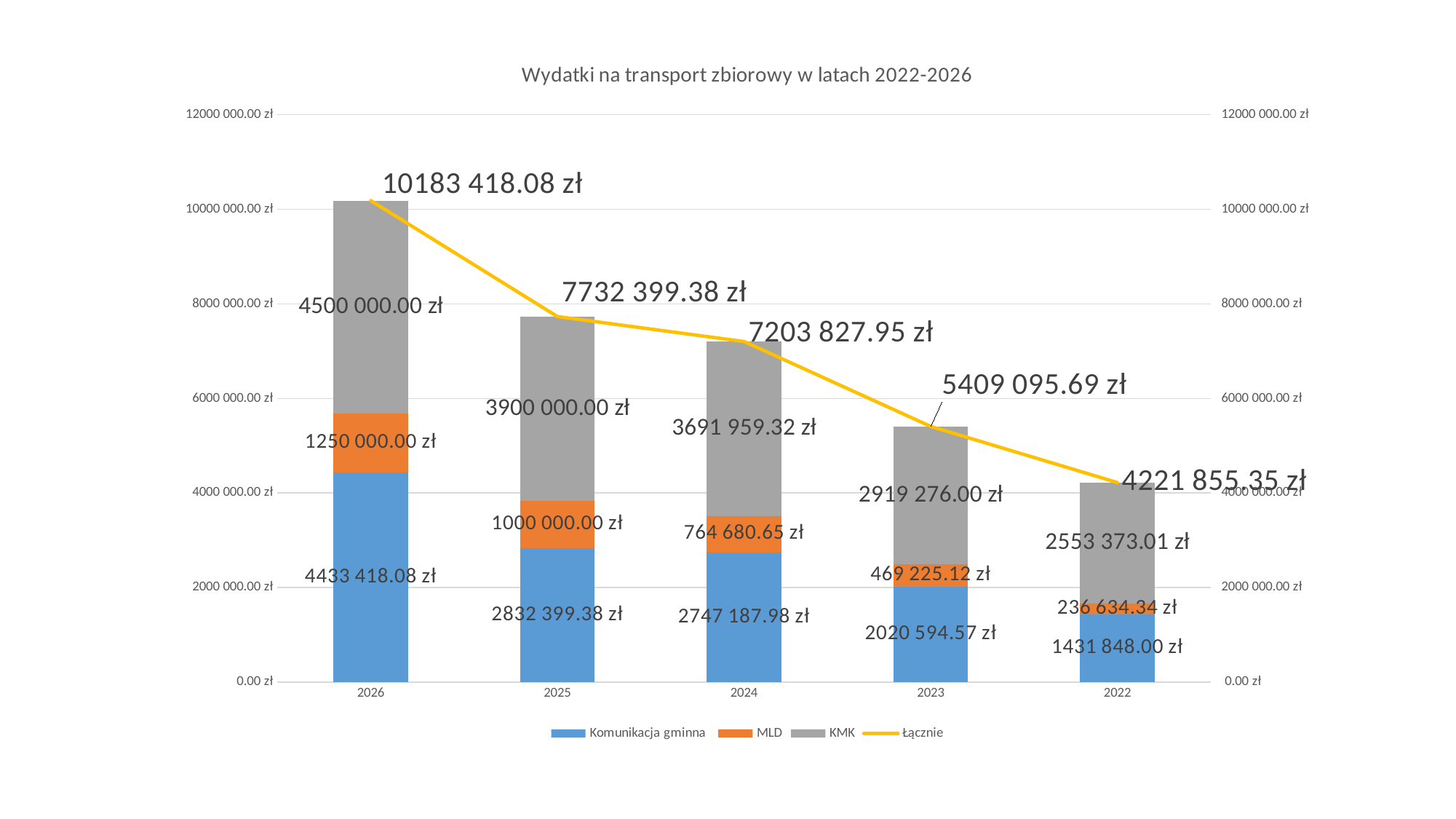
How many years are shown on the x axis? 5 What is the Łącznie value for 2023? 5409 095.69 zł What is the difference between the KMK values for 2026 and 2025? 600 000.00 zł What kind of chart is this? Stacked bar chart with a line Which is larger, the MLD value for 2024 or the MLD value for 2023? 2024 What is the MLD value for 2022? 236 634.34 zł How many series does the legend list? 4 Which year has the highest Łącznie value? 2026 What is the KMK value for 2024? 3691 959.32 zł Do the Łącznie values rise or fall from left to right along the x axis? Fall What is the value of Komunikacja gminna for 2026? 4433 418.08 zł Which year has the lowest Komunikacja gminna value? 2022